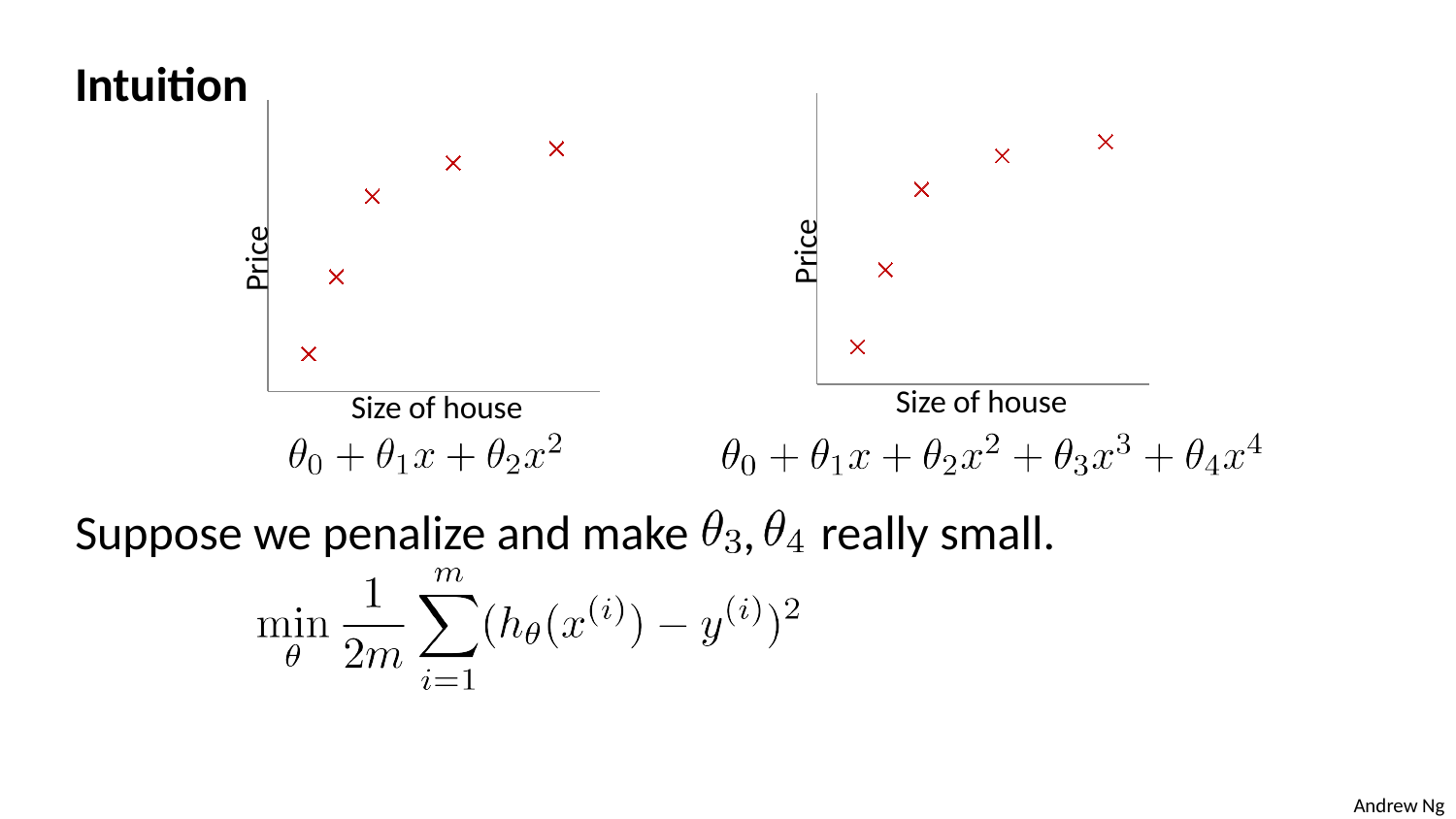
In the right chart, does Price rise or fall as Size of house increases? rise What kind of chart is the right chart on the slide? scatter plot How many charts are shown on the slide? 2 What kind of chart is the left chart on the slide? scatter plot How many data points are plotted in the left chart? 5 What is the x-axis label of the left chart? Size of house How many data points are plotted in the right chart? 5 What is the y-axis label of the right chart? Price In the left chart, does Price rise or fall as Size of house increases? rise